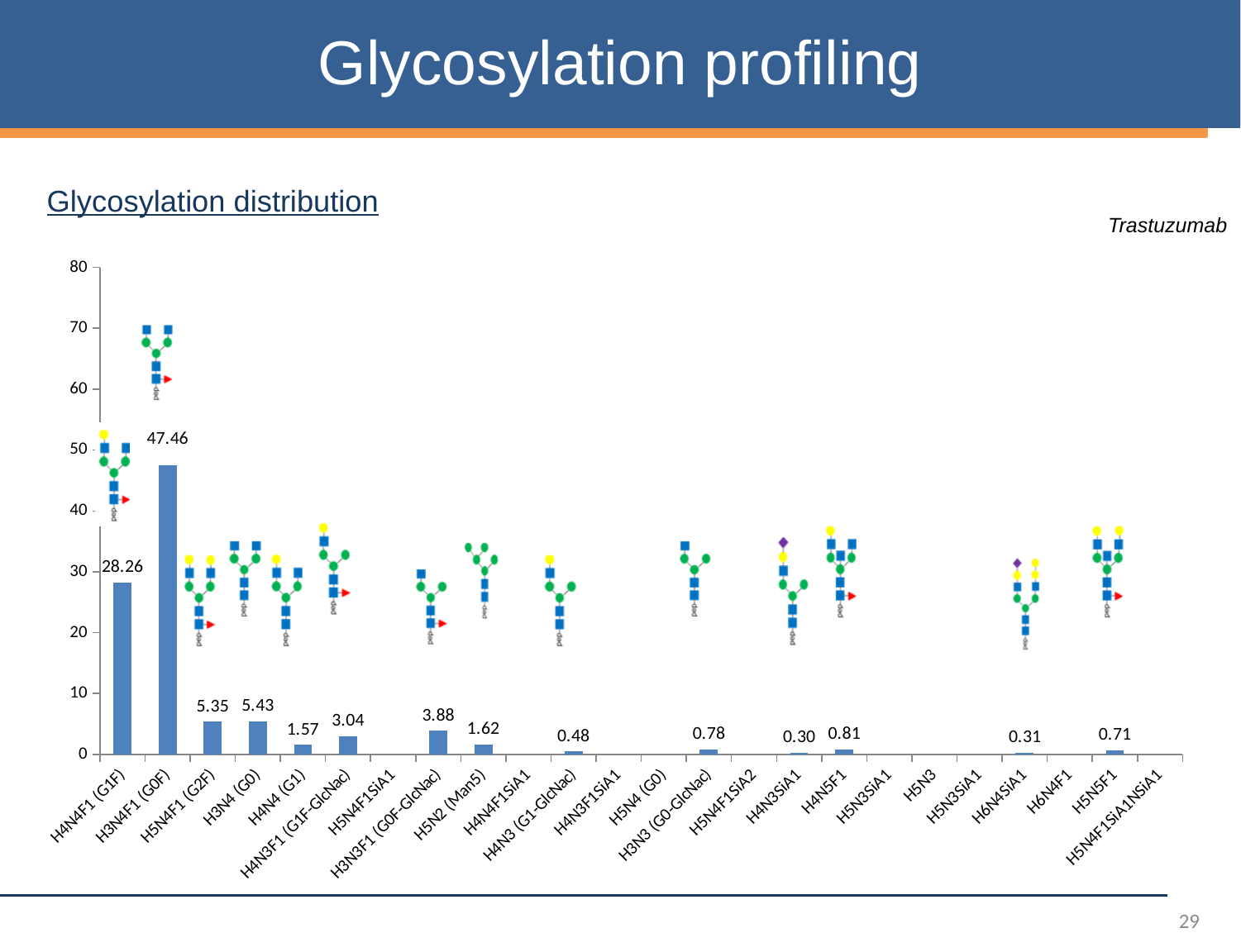
What is the value for H4N5F1? 0.81 Which is larger, the value for H3N4 (G0) or the value for H5N4F1 (G2F)? H3N4 (G0) What kind of chart is shown on the slide? bar chart What is the value for H3N3F1 (G0F-GlcNac)? 3.88 What is the value for H3N4F1 (G0F)? 47.46 What is the value for H4N4F1 (G1F)? 28.26 How many categories are shown on the x axis? 24 Which antibody is named in italics above the chart? Trastuzumab Which category has the highest value? H3N4F1 (G0F) What is the difference between the values for H3N4F1 (G0F) and H4N4F1 (G1F)? 19.20 Is the value for H3N4F1 (G0F) greater or less than 40? greater What is the value for H5N2 (Man5)? 1.62